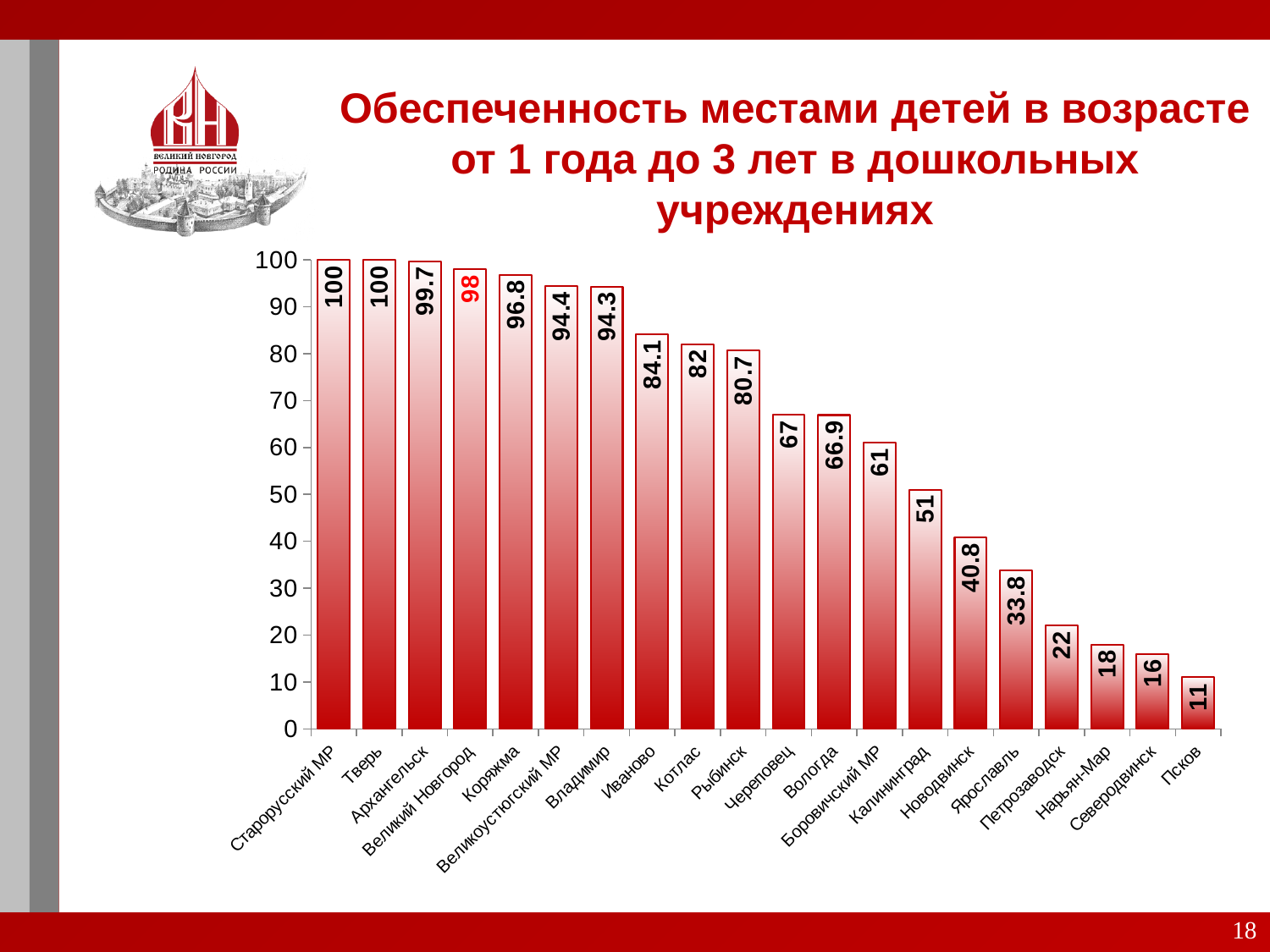
What is the value for Великий Новгород? 98 What is the difference between the values for Иваново and Рыбинск? 3.4 Which is larger, the value for Коряжма or the value for Владимир? Коряжма Do the values rise or fall from left to right along the x axis? Fall What is the difference between the values for Череповец and Ярославль? 33.2 Which is larger, the value for Петрозаводск or the value for Северодвинск? Петрозаводск What is the value for Калининград? 51 What kind of chart is shown on the slide? Bar chart What is the value for Новодвинск? 40.8 Which category has the lowest value? Псков How many categories are shown on the chart? 20 What is the value for Котлас? 82